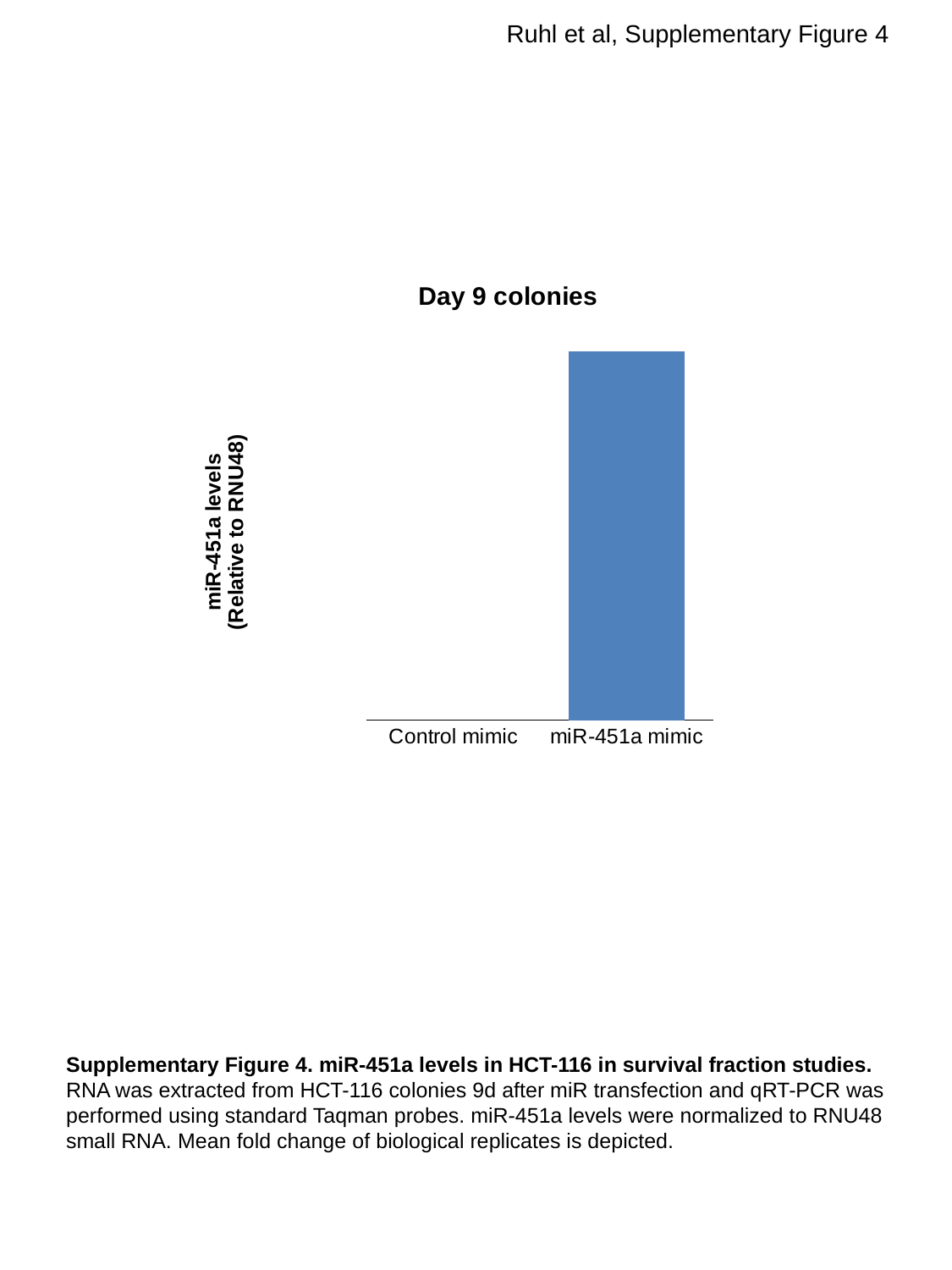
Which category has the lowest miR-451a level in the chart? Control mimic What is the title of the chart? Day 9 colonies How many categories are shown on the x axis of the chart? 2 Which category has the highest miR-451a level in the chart? miR-451a mimic What kind of chart is shown on the slide? bar chart Which is larger, the value for Control mimic or the value for miR-451a mimic? miR-451a mimic Do the values rise or fall from Control mimic to miR-451a mimic along the x axis? rise What is the label of the y axis of the chart? miR-451a levels (Relative to RNU48)